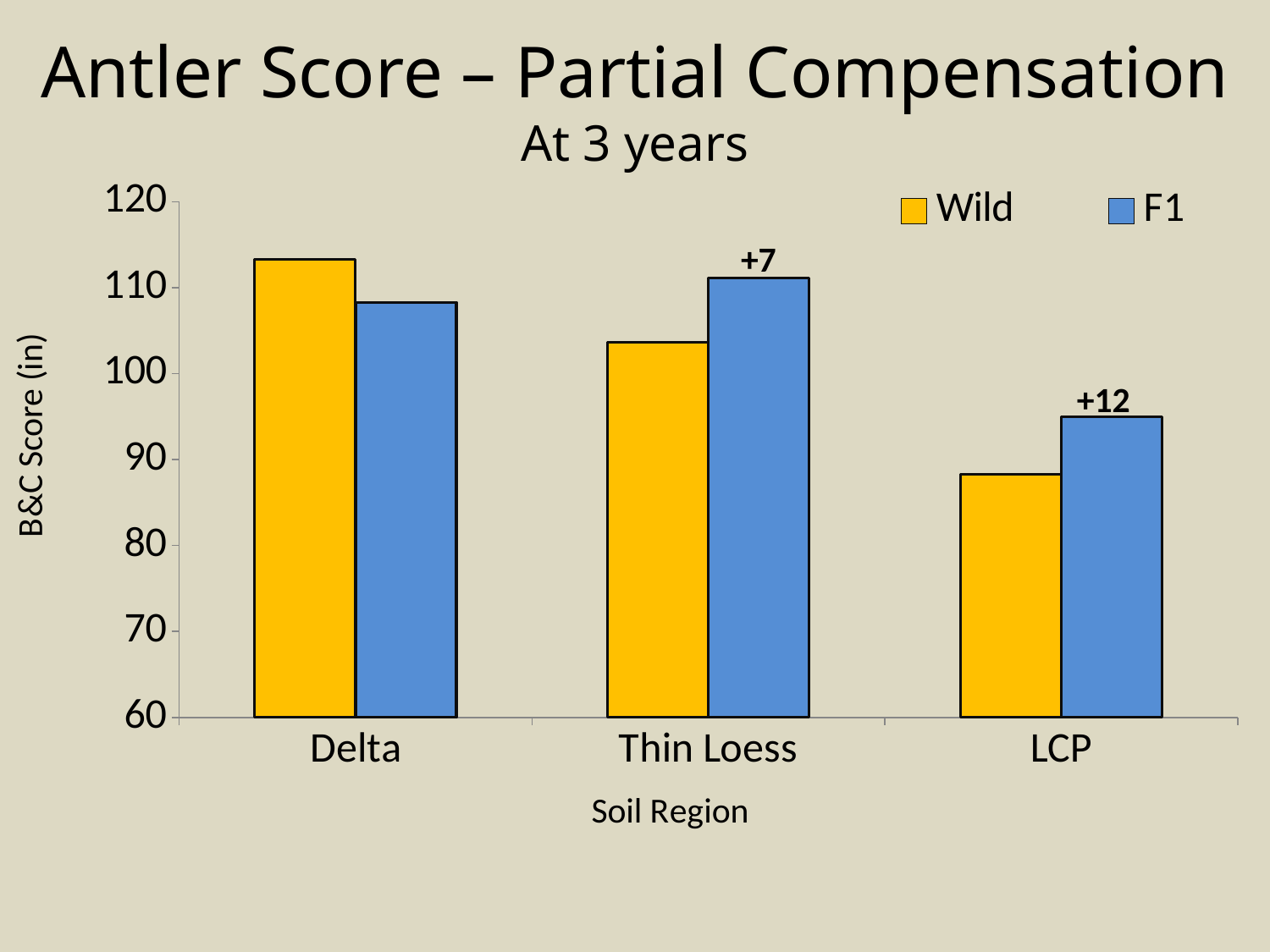
How many series does the legend list? 2 What kind of chart is shown on the slide? bar chart Do the Wild values rise or fall moving from Delta to LCP along the x axis? fall Is the Wild value for Delta greater or less than 110? greater Is the Wild value for LCP greater or less than 90? less How many soil regions are shown on the x axis? 3 Which soil region has the highest Wild value? Delta What label is printed above the F1 bar for Thin Loess? +7 Which soil region has the lowest F1 value? LCP For Delta, which is larger, the Wild bar or the F1 bar? Wild For LCP, which is larger, the Wild bar or the F1 bar? F1 What is the title of the y axis? B&C Score (in)